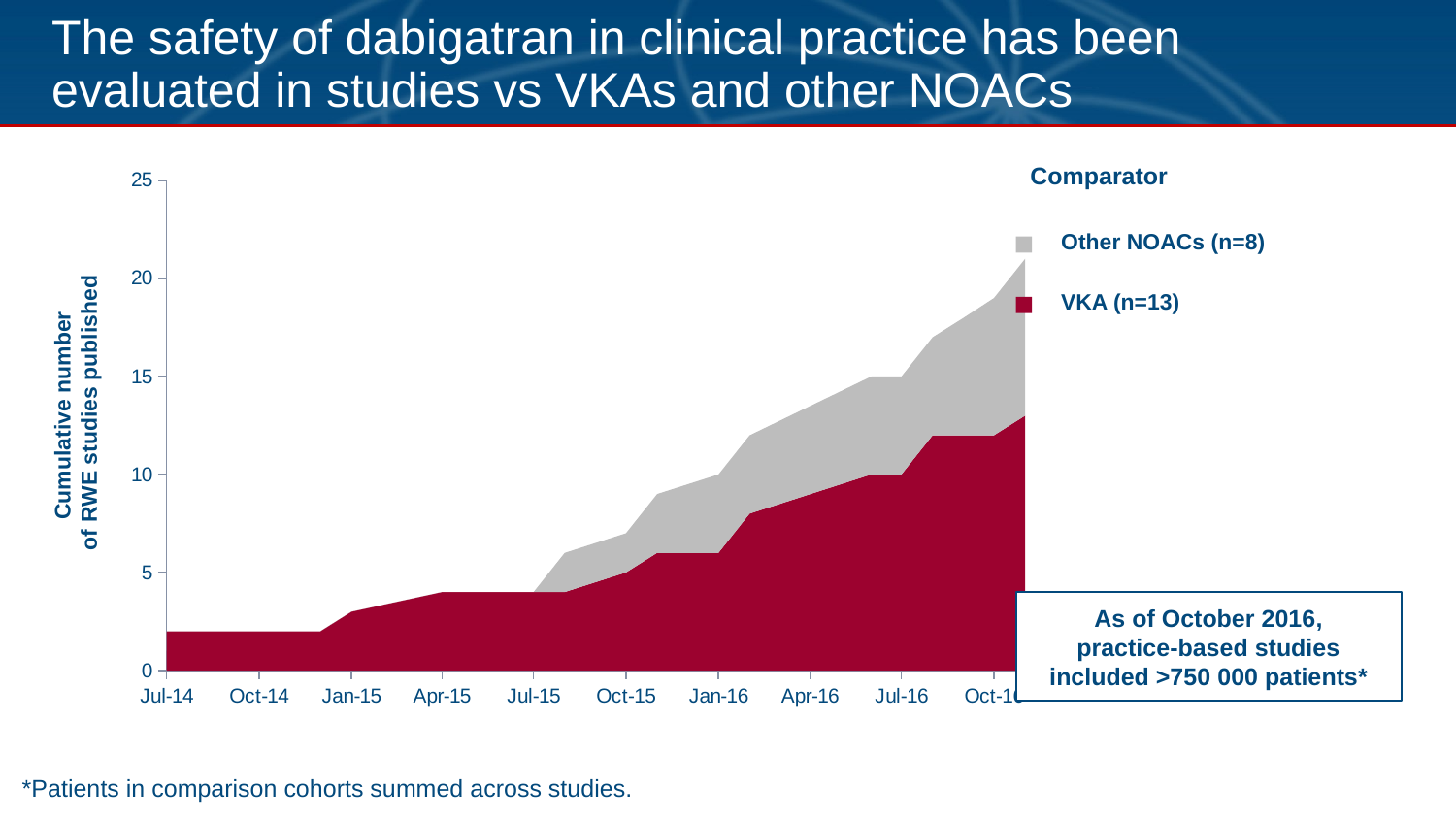
Is the cumulative number of VKA studies at Jul-14 greater or less than 5? less How many date labels are shown on the x axis? 10 What kind of chart is shown on the slide? Stacked area chart Which comparator group has more studies, VKA or Other NOACs? VKA How many series does the legend list? 2 What is the difference between the number of VKA studies and the number of Other NOACs studies shown in the legend? 5 According to the legend, how many studies used other NOACs as the comparator? 8 What is the total number of studies across both comparator groups listed in the legend? 21 Does the cumulative number of RWE studies published rise or fall over time along the x axis? rise What is the title of the y axis? Cumulative number of RWE studies published According to the legend, how many studies used VKA as the comparator? 13 Is the cumulative number of VKA studies at Oct-16 greater or less than 10? greater